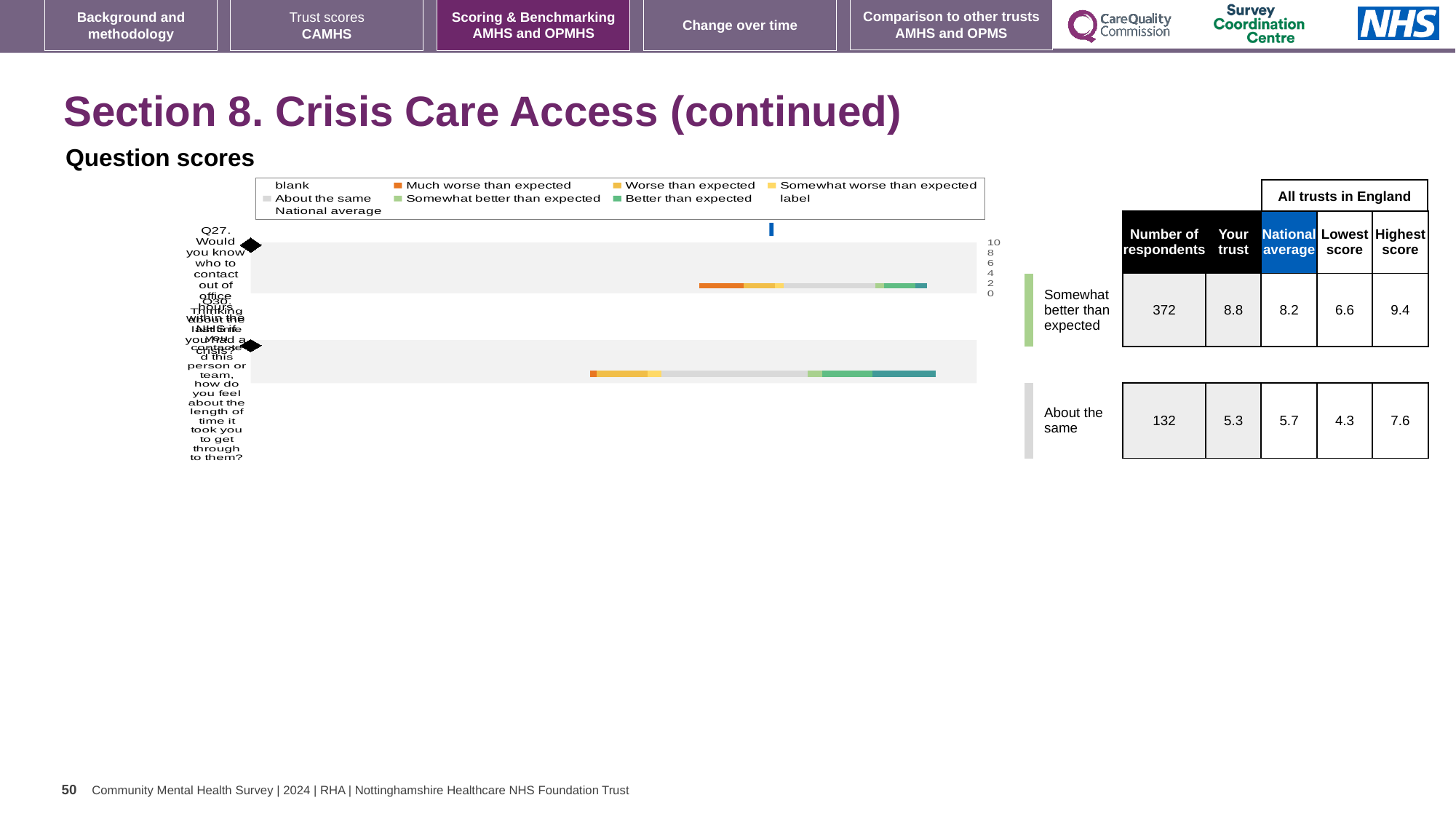
What is the heading above the chart on this slide? Question scores What is the Lowest score among all trusts in England for the 'Somewhat better than expected' row (Q27)? 6.6 What is the 'Your trust' score for the row rated 'Somewhat better than expected' (Q27)? 8.8 Which row has the higher 'Your trust' score, Q27 or Q30? Q27 What is the Highest score among all trusts in England for the 'About the same' row (Q30)? 7.6 What benchmark category is assigned to Q30 in the Question scores chart? About the same How many respondents are shown for the 'Somewhat better than expected' row (Q27)? 372 What is the National average for the row rated 'About the same' (Q30)? 5.7 By how much does the 'Your trust' score exceed the National average for the 'Somewhat better than expected' row (Q27)? 0.6 How many questions (rows) are plotted in the Question scores chart? 2 What kind of chart is shown under 'Question scores'? Bar chart For the 'About the same' row (Q30), which is larger: the 'Your trust' score or the National average? National average